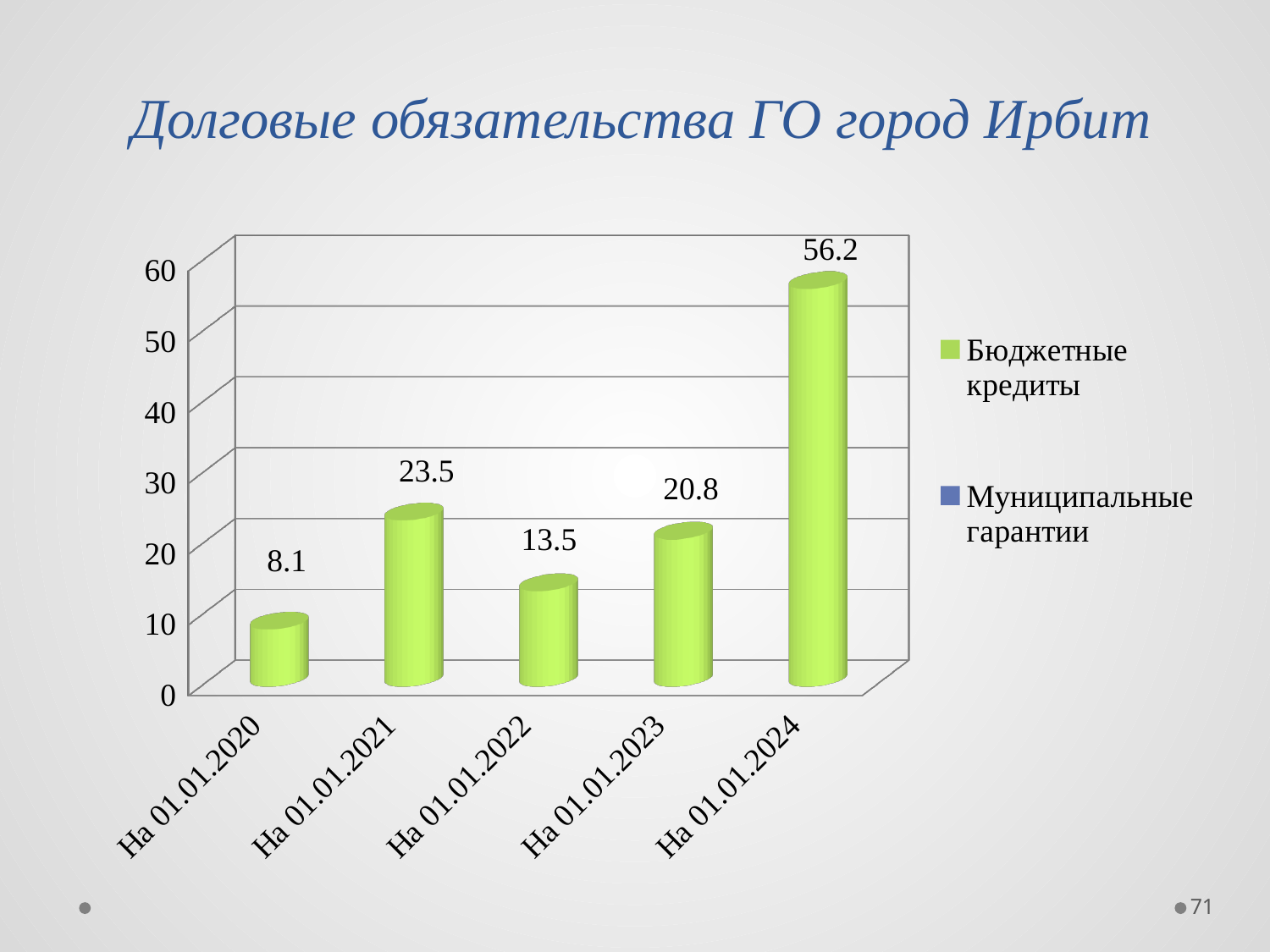
How many series does the legend list? 2 Which date has the lowest value of Бюджетные кредиты? На 01.01.2020 What is the difference between the values for На 01.01.2024 and На 01.01.2023? 35.4 What is the title of the chart? Долговые обязательства ГО город Ирбит What is the value of Бюджетные кредиты for На 01.01.2020? 8.1 What is the value of Бюджетные кредиты for На 01.01.2022? 13.5 Which is larger: the value for На 01.01.2021 or На 01.01.2023? На 01.01.2021 Is the value for На 01.01.2024 greater or less than 50? greater How many dates are shown on the x axis? 5 What kind of chart is shown on the slide? bar chart Which date has the highest value of Бюджетные кредиты? На 01.01.2024 What is the value of Бюджетные кредиты for На 01.01.2024? 56.2